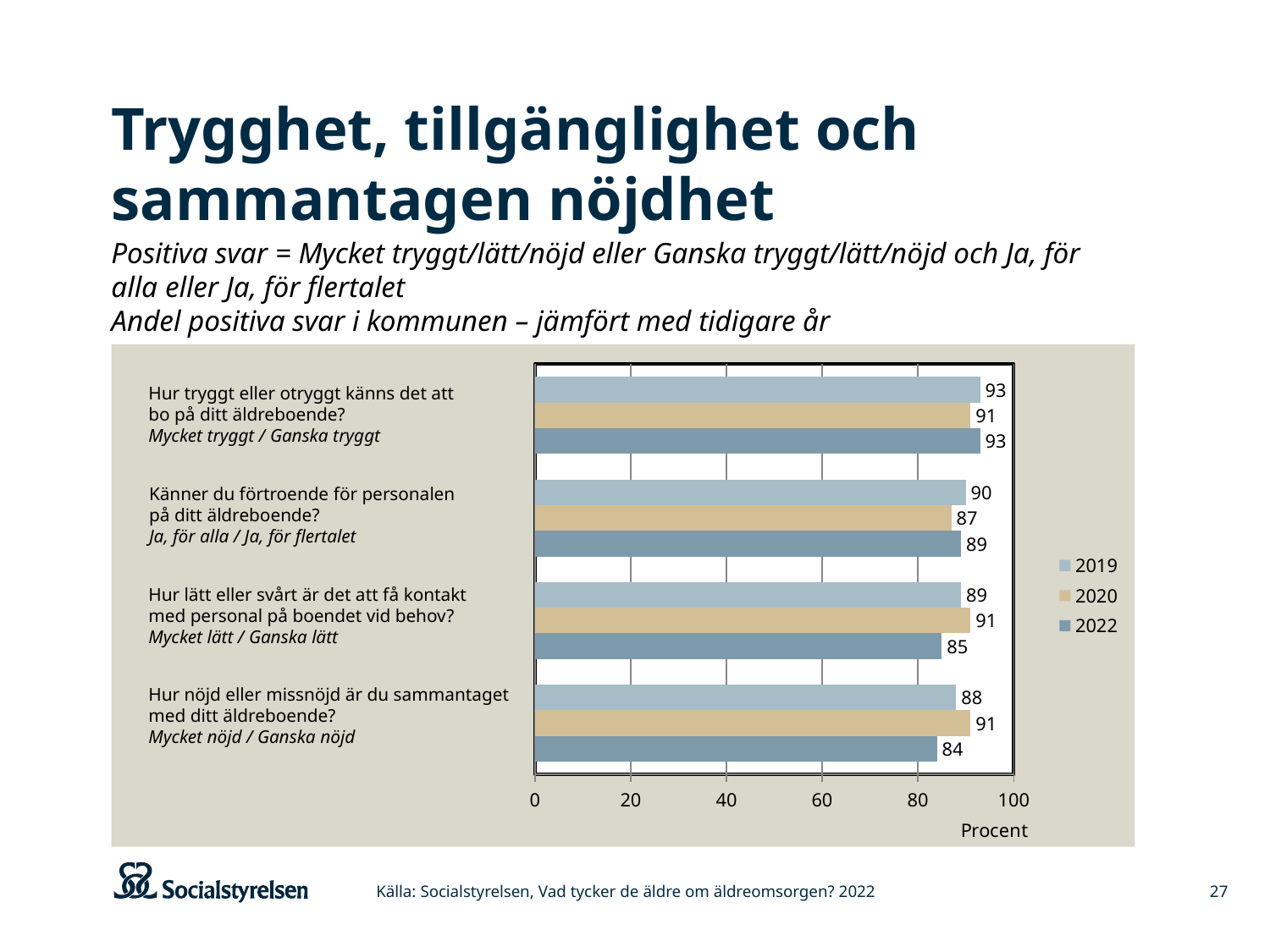
Is the 2022 value for "Känner du förtroende för personalen på ditt äldreboende?" greater or less than 80? greater How many series does the legend list? 3 What kind of chart is shown on the slide? Bar chart What is the 2020 value for "Känner du förtroende för personalen på ditt äldreboende?"? 87 For "Hur nöjd eller missnöjd är du sammantaget med ditt äldreboende?", which year has the larger value, 2019 or 2020? 2020 What is the label on the horizontal axis of the chart? Procent Which question has the highest 2022 value? Hur tryggt eller otryggt känns det att bo på ditt äldreboende? What is the 2022 value for "Hur nöjd eller missnöjd är du sammantaget med ditt äldreboende?"? 84 What is the 2019 value for "Hur lätt eller svårt är det att få kontakt med personal på boendet vid behov?"? 89 How many questions (categories) are shown in the chart? 4 Which question has the lowest 2022 value? Hur nöjd eller missnöjd är du sammantaget med ditt äldreboende? What is the difference between the 2020 and 2022 values for "Hur lätt eller svårt är det att få kontakt med personal på boendet vid behov?"? 6